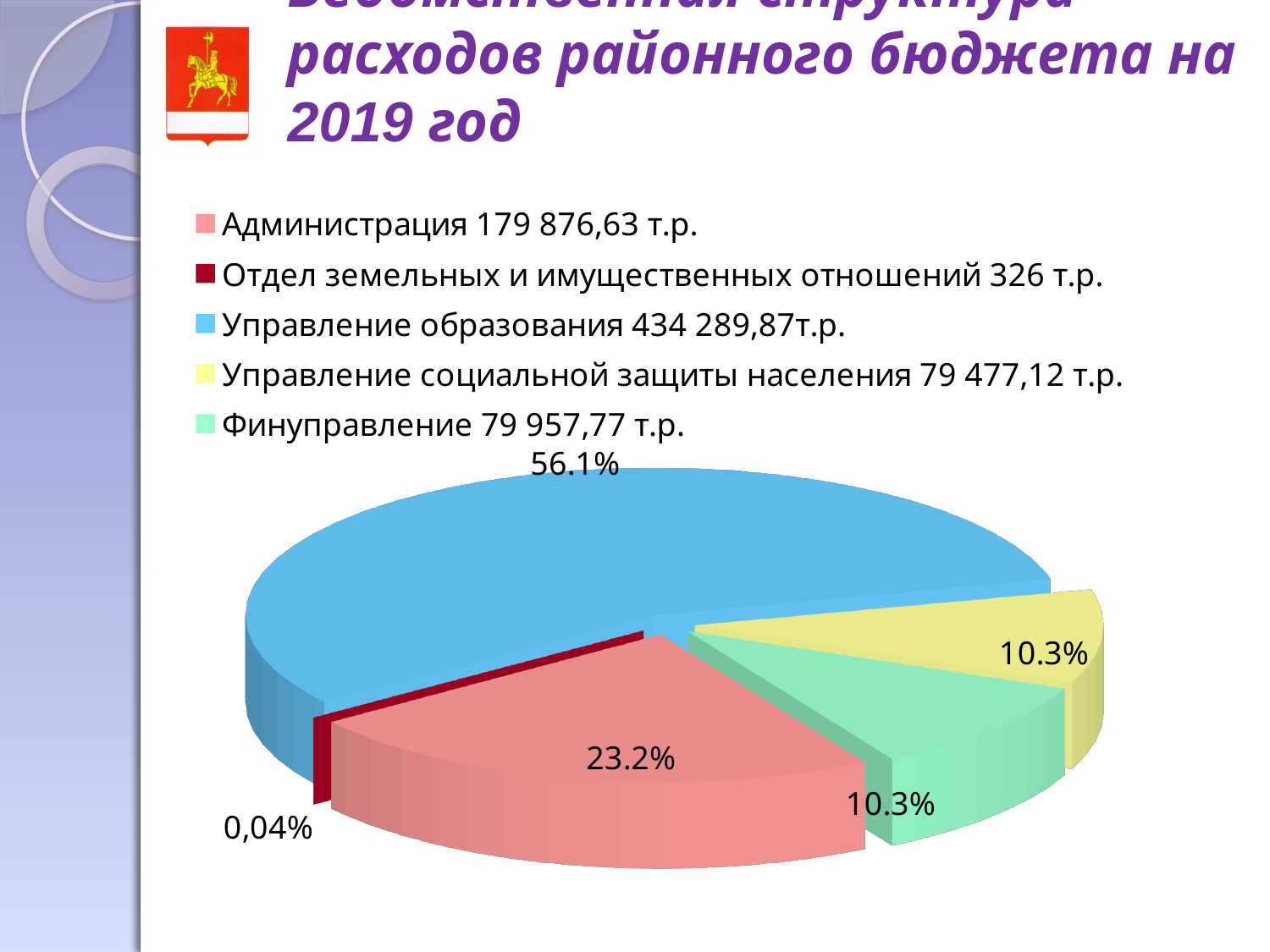
What is the difference in percentage points between the shares of Управление образования and Администрация? 32.9 percentage points How many categories are shown in the pie chart? 5 What share of the pie does Управление социальной защиты населения account for? 10.3% What amount is listed in the legend for Администрация? 179 876,63 т.р. What kind of chart is shown on the slide? Pie chart What share of the pie does Отдел земельных и имущественных отношений account for? 0,04% Which category has the largest slice of the pie? Управление образования Which category has the smallest slice of the pie? Отдел земельных и имущественных отношений What amount is listed in the legend for Финуправление? 79 957,77 т.р. Which has a larger share of the pie, Администрация or Финуправление? Администрация What share of the pie does Администрация account for? 23.2%